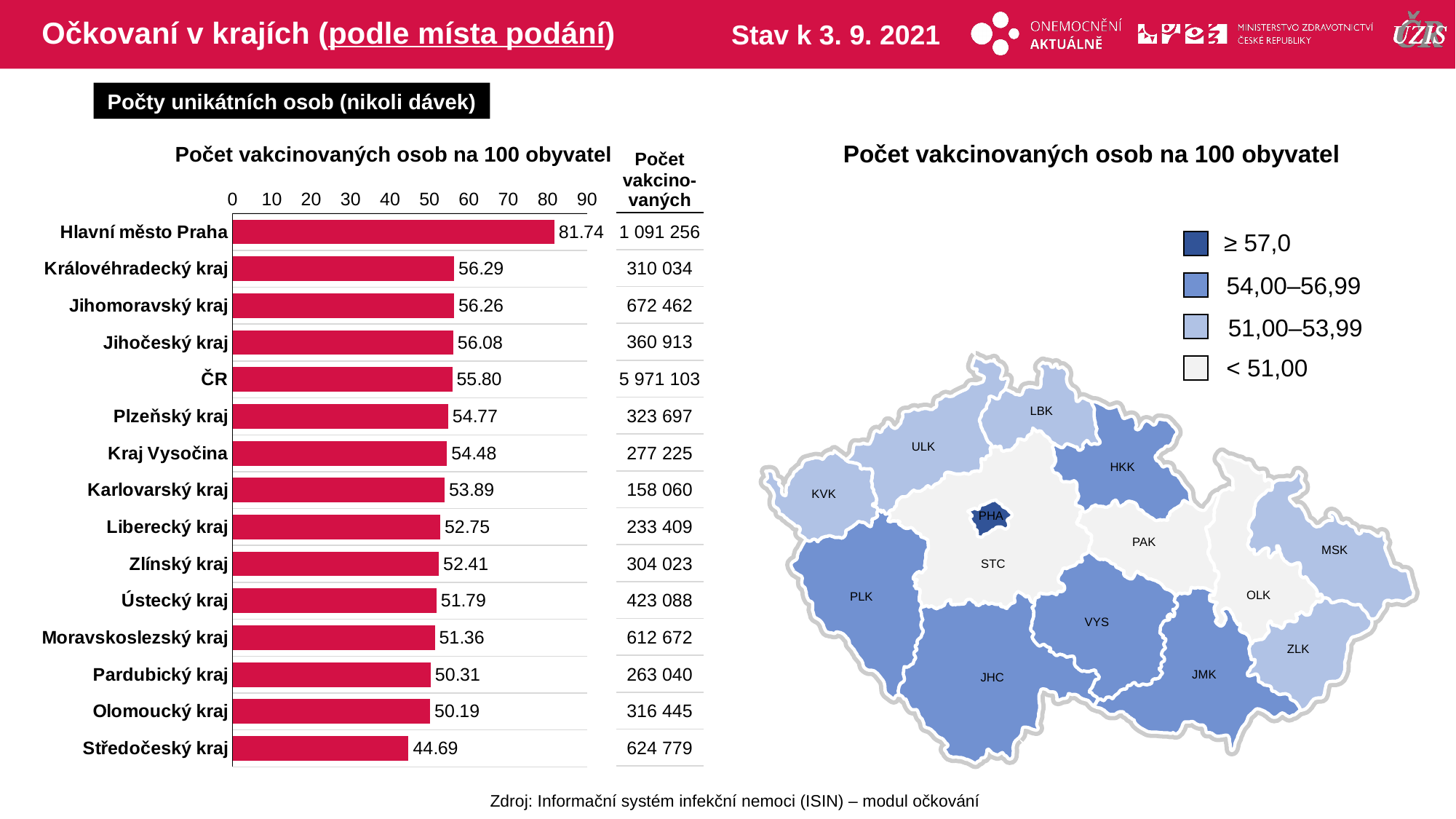
In the bar chart, do the values increase or decrease going from the top bar to the bottom bar? decrease In the bar chart, which has a higher value: Plzeňský kraj or Kraj Vysočina? Plzeňský kraj Which region has the highest number of vaccinated persons per 100 inhabitants in the bar chart? Hlavní město Praha What is the title of the bar chart on the left? Počet vakcinovaných osob na 100 obyvatel Which region has the lowest value in the bar chart? Středočeský kraj How many bars (categories) are shown in the bar chart? 15 What type of chart is used on the left side of the slide? bar chart In the bar chart, what is the difference between the values for Hlavní město Praha and Středočeský kraj? 37.05 In the bar chart, what is the number of vaccinated persons per 100 inhabitants for Hlavní město Praha? 81.74 In the bar chart, is the value for Středočeský kraj greater or less than 50? less In the bar chart, what is the value for Kraj Vysočina? 54.48 In the bar chart, what is the value shown for ČR? 55.80